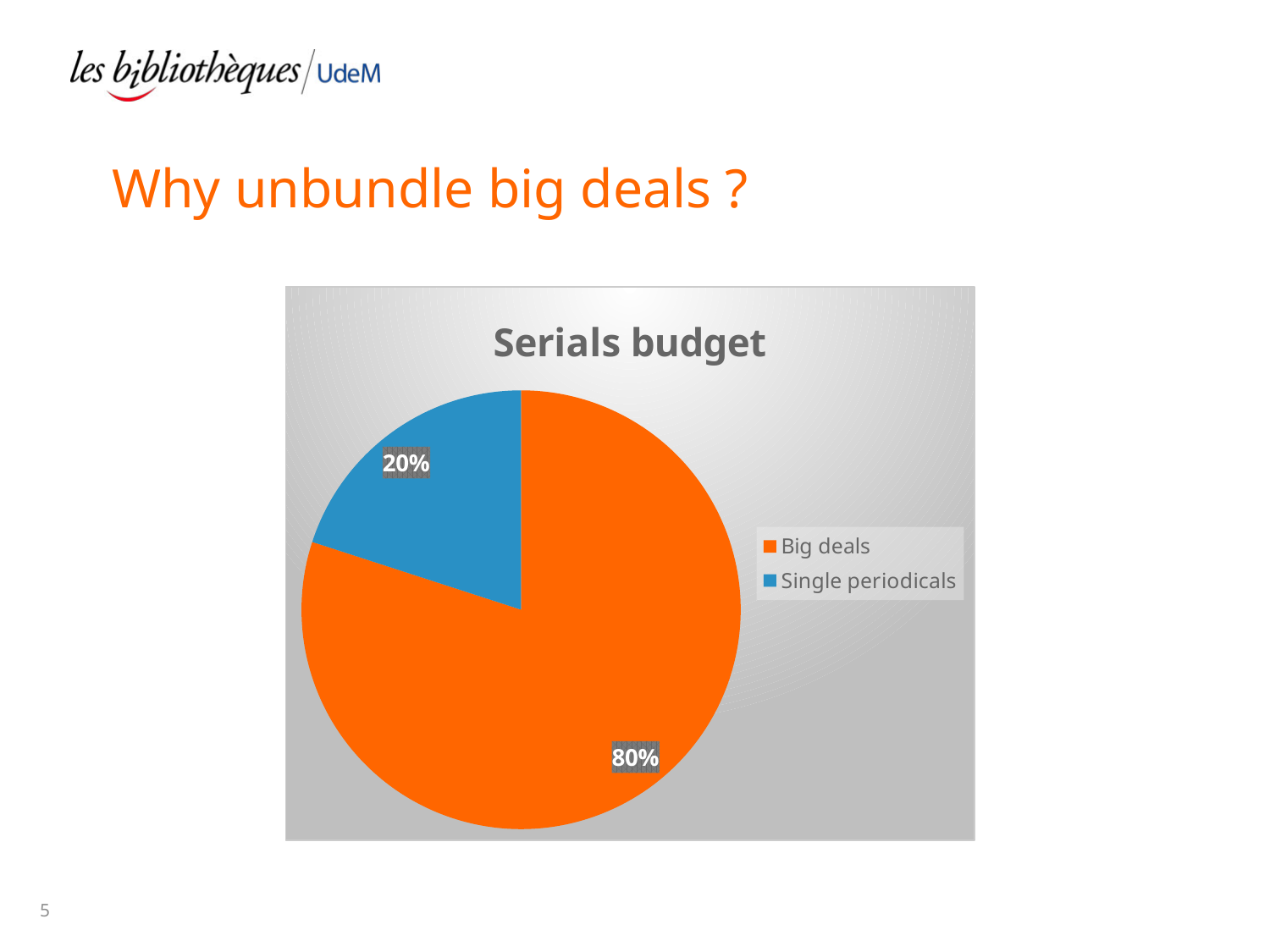
What share of the serials budget goes to Single periodicals? 20% What is the difference in percentage points between the Big deals share and the Single periodicals share? 60 percentage points What type of chart is shown on the slide? pie chart How many entries does the legend list? 2 Which category has the smallest share of the serials budget? Single periodicals How many categories does the pie chart show? 2 Which is larger, the share for Big deals or the share for Single periodicals? Big deals What is the title of the chart? Serials budget Is the share for Single periodicals greater or less than 50%? less What share of the serials budget goes to Big deals? 80% Which category has the largest share of the serials budget? Big deals What colour is the Big deals slice? orange